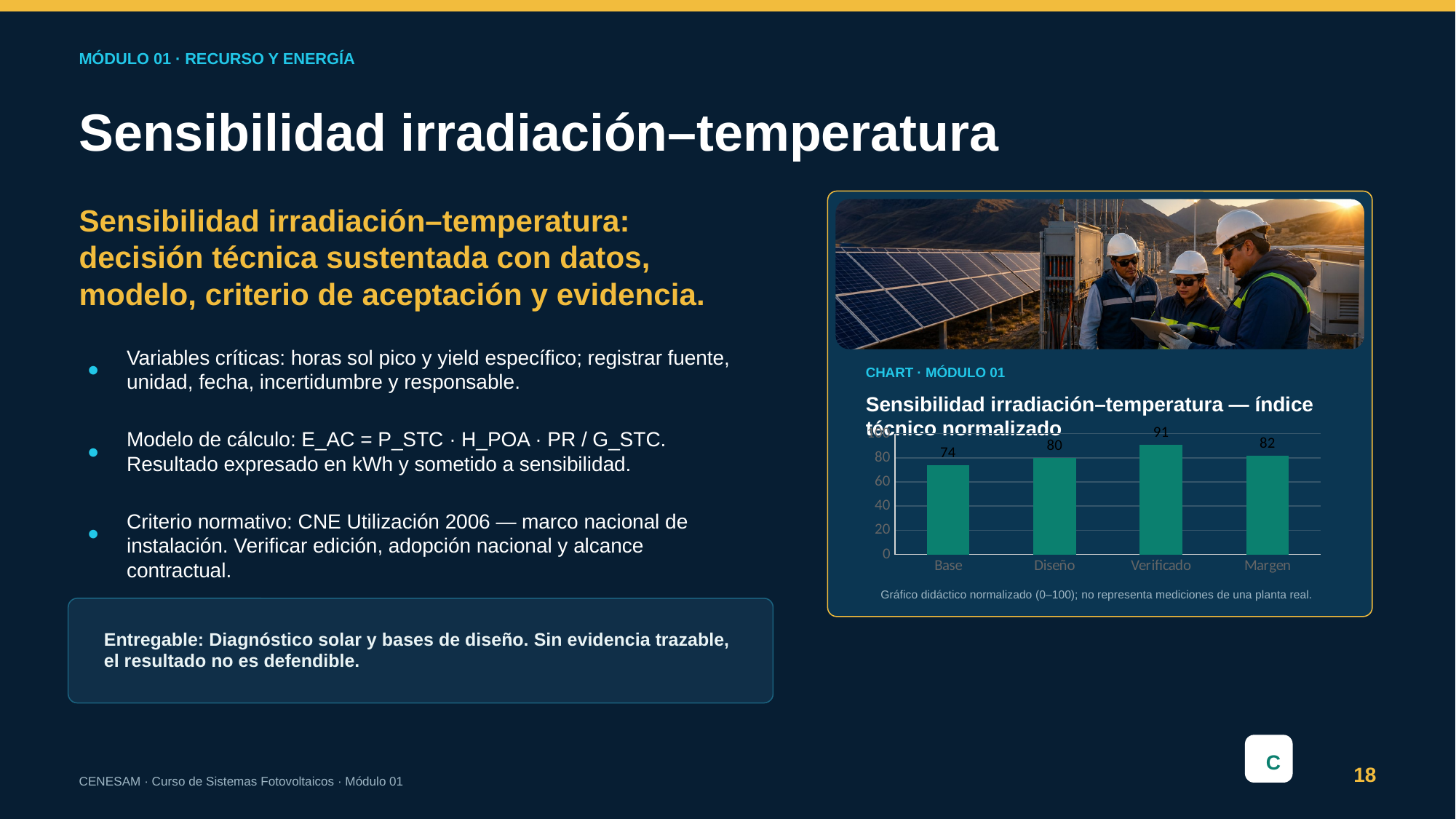
How many categories are shown on the x axis? 4 What kind of chart is shown on the slide? Bar chart What is the difference between the values for Verificado and Base? 17 What is the value for Base? 74 What is the value for Diseño? 80 Is the value for Base greater or less than 80? less Which category has the highest value? Verificado What is the title of the chart? Sensibilidad irradiación–temperatura — índice técnico normalizado What is the value for Verificado? 91 What is the value for Margen? 82 Which is larger, the value for Margen or the value for Diseño? Margen Which category has the lowest value? Base